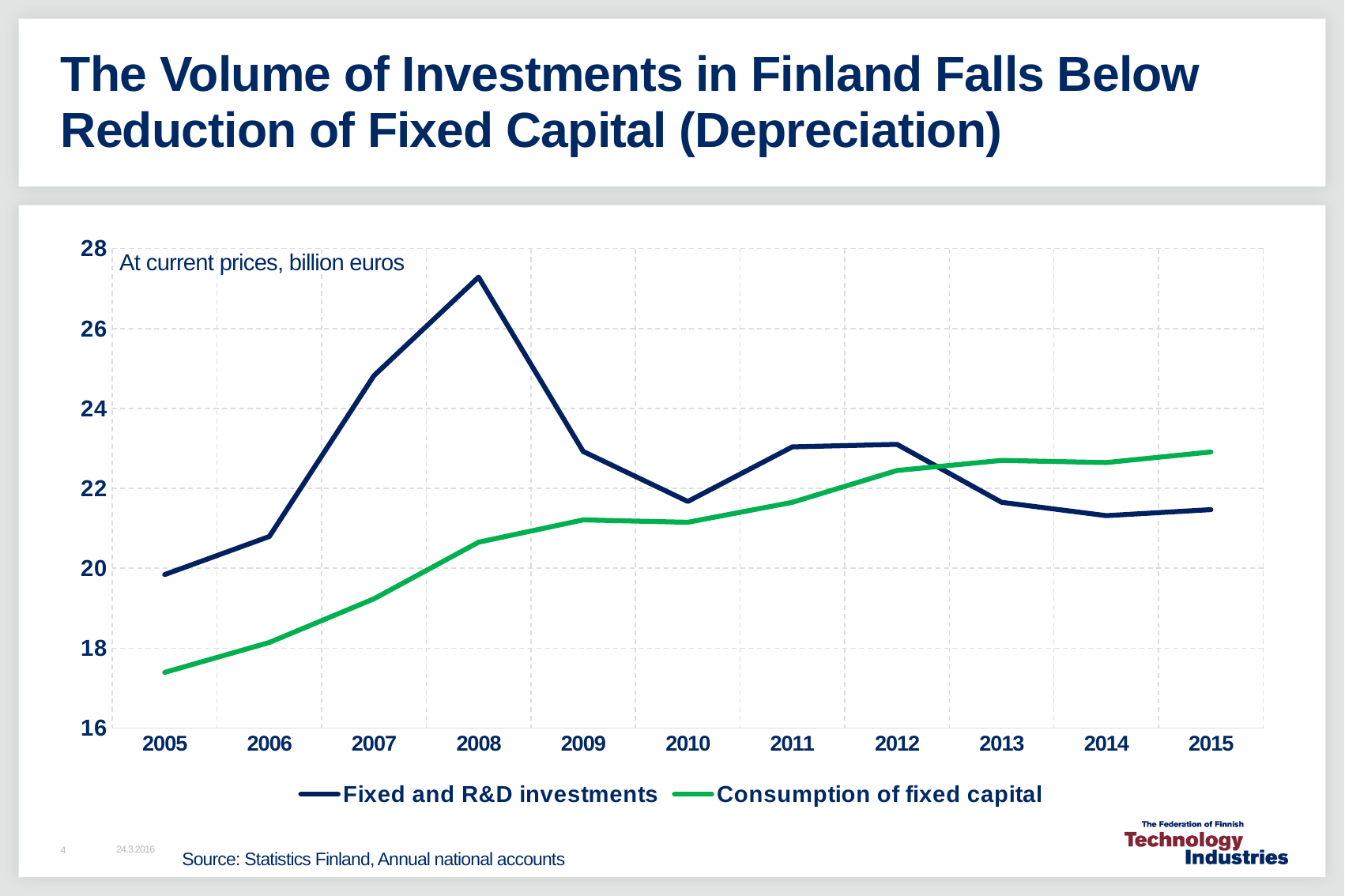
Is the value for Fixed and R&D investments in 2008 greater or less than 26? greater Does Consumption of fixed capital rise or fall from 2005 to 2015? Rises What kind of chart is shown on the slide? Line chart In which year is Fixed and R&D investments at its lowest value? 2005 How many years are shown on the x axis? 11 Is the value for Consumption of fixed capital in 2005 greater or less than 18? less In which year is Consumption of fixed capital at its lowest value? 2005 In which year does Fixed and R&D investments reach its highest value? 2008 In 2015, which series has the higher value, Fixed and R&D investments or Consumption of fixed capital? Consumption of fixed capital How many series does the legend list? 2 Is the value for Fixed and R&D investments in 2010 greater or less than 22? less In what units are the values on the chart expressed, according to the note on the chart? At current prices, billion euros